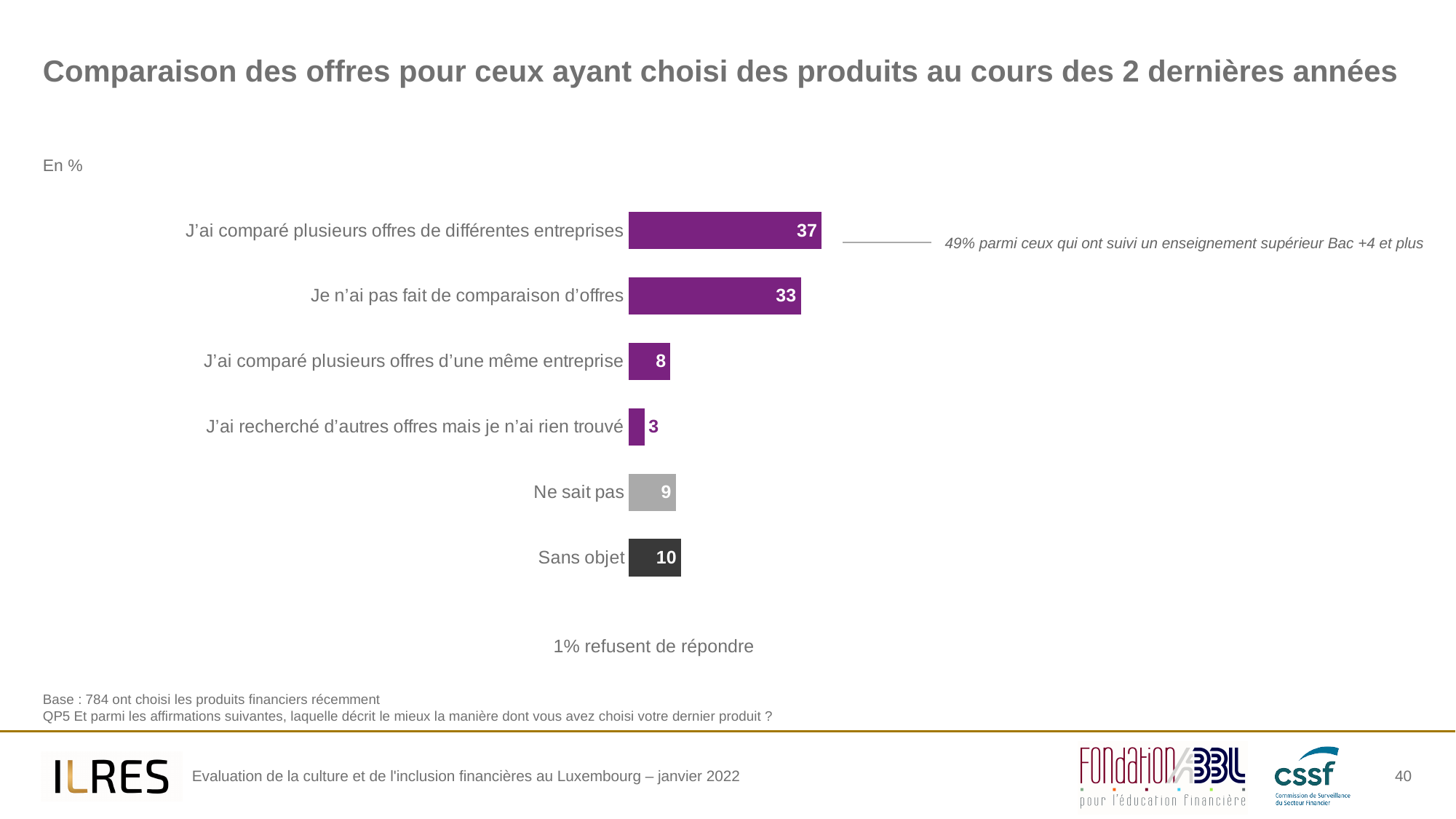
What is the value for "J'ai comparé plusieurs offres de différentes entreprises"? 37 Which is larger: "J'ai comparé plusieurs offres d'une même entreprise" or "Ne sait pas"? Ne sait pas Which category has the lowest value? J'ai recherché d'autres offres mais je n'ai rien trouvé What percentage is given in the annotation for those with higher education Bac +4 and above? 49% What is the value for "Ne sait pas"? 9 What is the value for "Sans objet"? 10 What is the value for "Je n'ai pas fait de comparaison d'offres"? 33 How many categories are shown in the bar chart? 6 What is the difference between "J'ai comparé plusieurs offres de différentes entreprises" and "Je n'ai pas fait de comparaison d'offres"? 4 Which category has the highest value? J'ai comparé plusieurs offres de différentes entreprises What is the difference between "Sans objet" and "J'ai recherché d'autres offres mais je n'ai rien trouvé"? 7 What kind of chart is shown on the slide? Bar chart